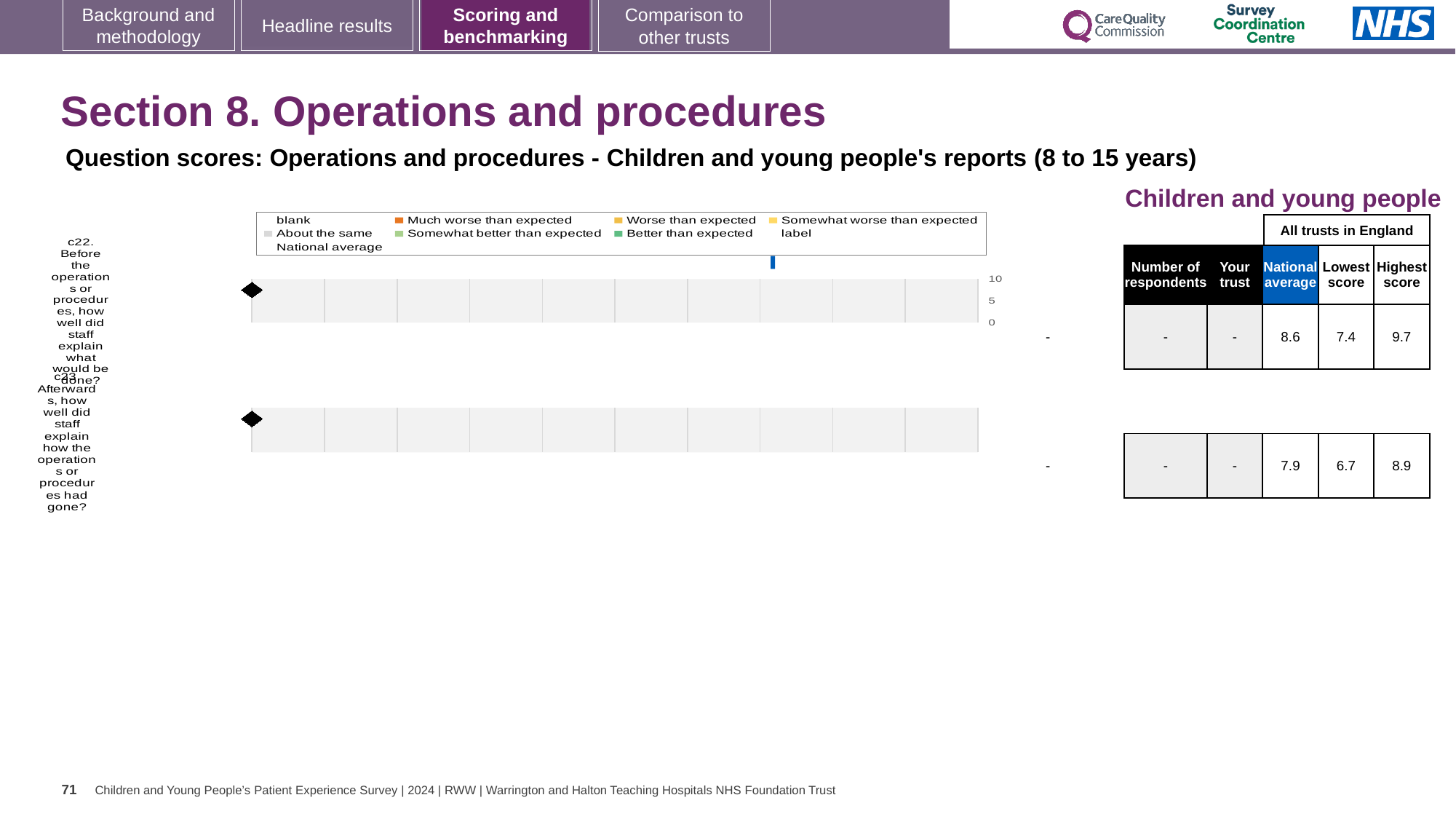
What is shown as the 'Your trust' score for c22? - What is the highest score among all trusts in England for c23? 8.9 What is the national average score for c22 (Before the operations or procedures, how well did staff explain what would be done?)? 8.6 How many entries does the chart legend list? 9 What kind of chart is used to show the question scores for Operations and procedures? bar chart What is the lowest score among all trusts in England for c22? 7.4 What is the highest tick value shown on the chart's score axis? 10 What is the difference between the highest score and the lowest score for c23? 2.2 What is the national average score for c23 (Afterwards, how well did staff explain how the operations or procedures had gone?)? 7.9 How many questions (categories) are plotted on the chart? 2 Which question has the higher national average, c22 or c23? c22 What is the difference between the highest score and the lowest score for c22? 2.3